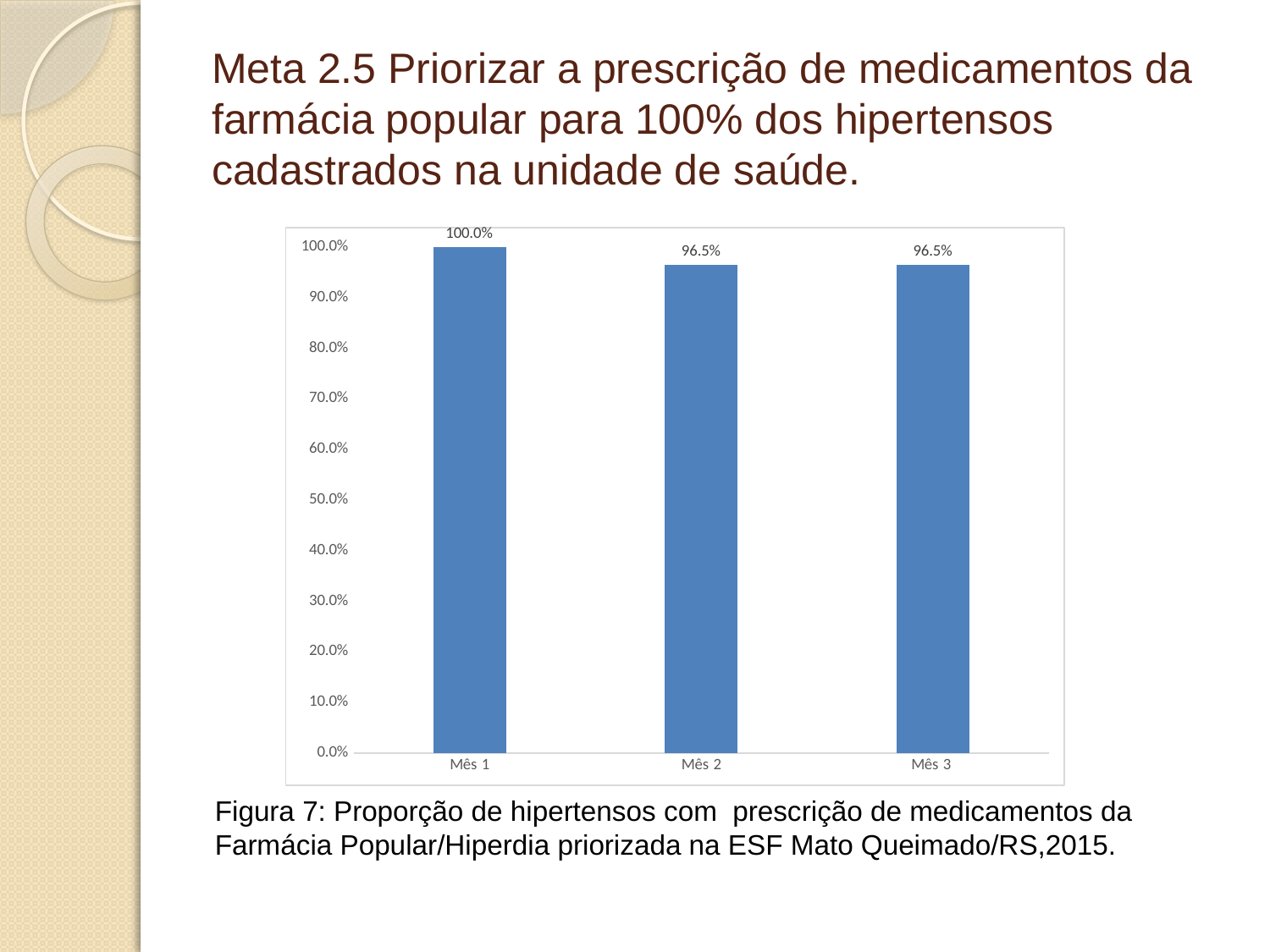
What is the value for Mês 3? 96.5% Which is larger, the value for Mês 1 or the value for Mês 3? Mês 1 What is the value for Mês 2? 96.5% What is the value for Mês 1? 100.0% What kind of chart is shown on the slide? bar chart Which month has the highest value? Mês 1 What is the figure number given in the caption below the chart? Figura 7 Does the value rise or fall from Mês 1 to Mês 2? fall What is the difference between the values for Mês 1 and Mês 2? 3.5% Do the values for Mês 2 and Mês 3 differ? No, both are 96.5% Is the value for Mês 2 greater or less than 90.0%? greater How many months are shown on the x axis? 3